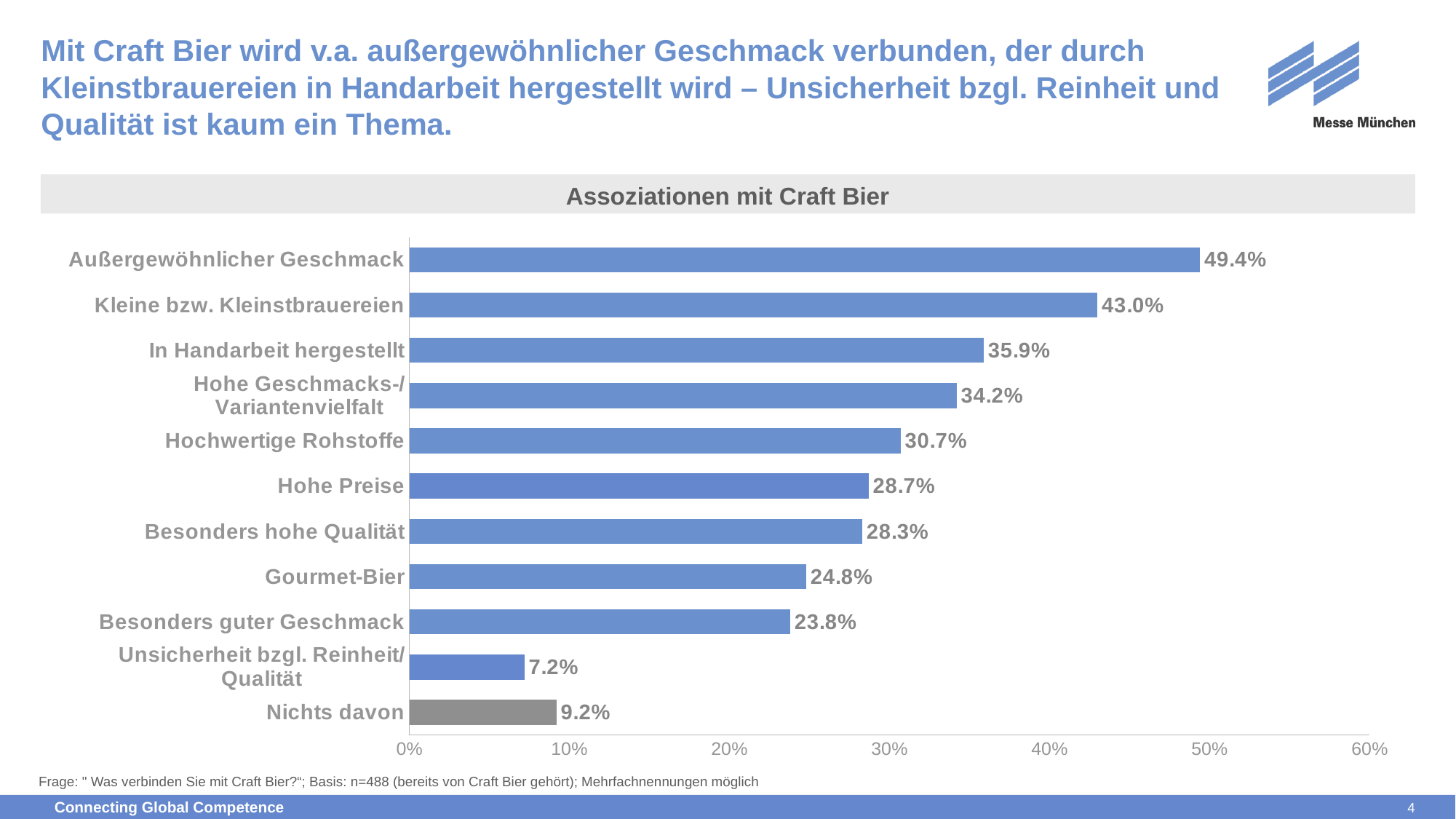
What is the difference between the values for Außergewöhnlicher Geschmack and Kleine bzw. Kleinstbrauereien? 6.4% What is the value for Hochwertige Rohstoffe? 30.7% What is the title of the chart? Assoziationen mit Craft Bier Is the value for In Handarbeit hergestellt greater or less than 30%? greater Which category's bar is coloured grey instead of blue? Nichts davon What kind of chart is shown on the slide? bar chart Which is larger, the value for Gourmet-Bier or the value for Besonders guter Geschmack? Gourmet-Bier Which category has the highest value? Außergewöhnlicher Geschmack What is the value for Außergewöhnlicher Geschmack? 49.4% How many categories are shown in the chart? 11 Which category has the lowest value? Unsicherheit bzgl. Reinheit/ Qualität What is the value for Unsicherheit bzgl. Reinheit/ Qualität? 7.2%